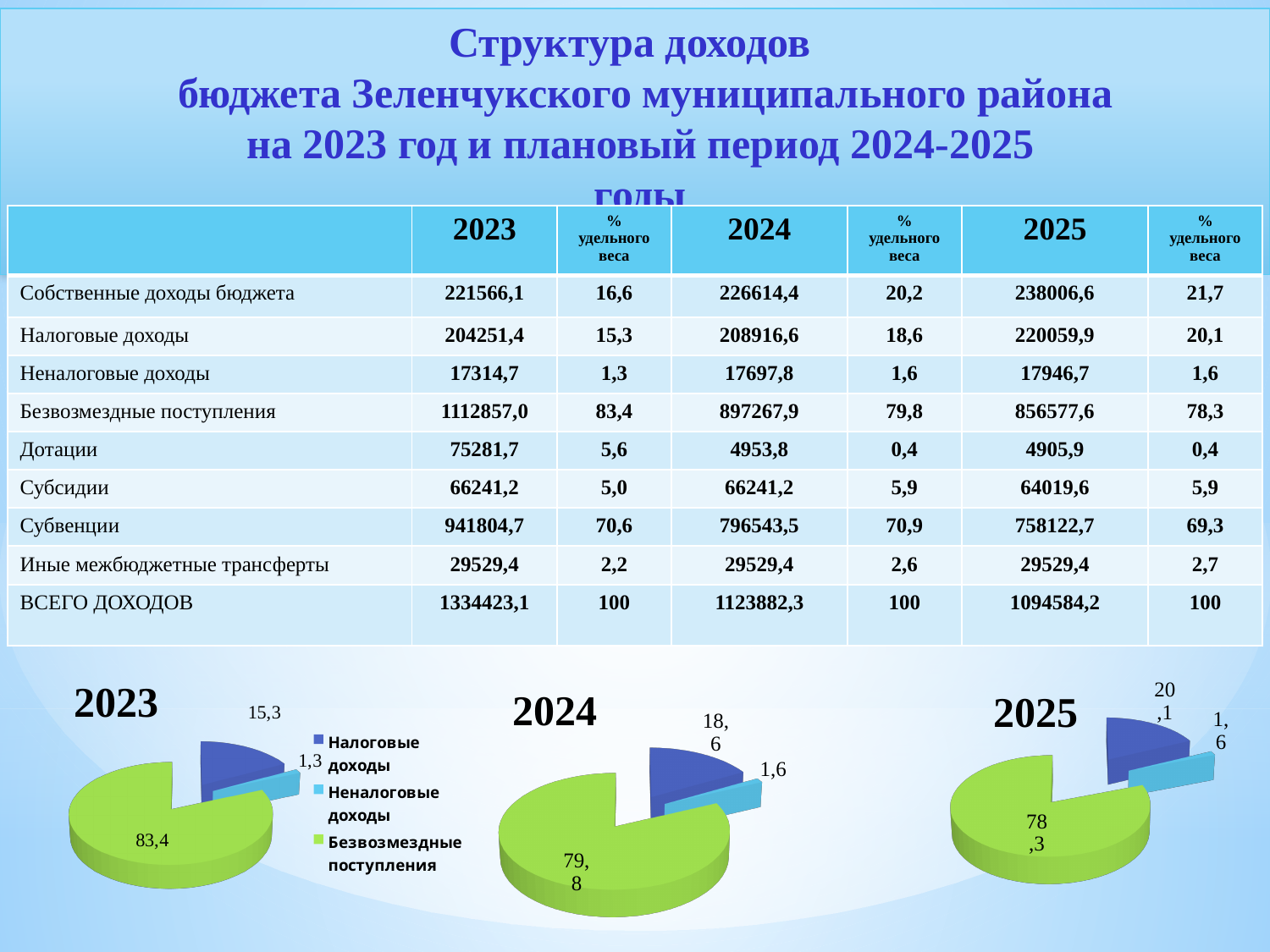
In the 2024 pie chart, what is the value shown for Неналоговые доходы? 1,6 In the 2024 pie chart, which is larger: Налоговые доходы or Неналоговые доходы? Налоговые доходы In the 2025 pie chart, what is the value shown for Налоговые доходы? 20,1 In the 2025 pie chart, which slice is the largest? Безвозмездные поступления In the 2024 pie chart, which slice is the smallest? Неналоговые доходы In the 2023 pie chart, what is the value shown for Безвозмездные поступления? 83,4 What kind of chart is the 2023 chart at the bottom left of the slide? pie chart How many slices does the 2025 pie chart have? 3 How many entries does the legend next to the 2023 pie chart list? 3 In the 2023 pie chart, what is the difference between the values for Безвозмездные поступления and Налоговые доходы? 68,1 In the 2023 pie chart, what is the value shown for Налоговые доходы? 15,3 In the legend next to the 2023 pie chart, which colour represents Безвозмездные поступления? green